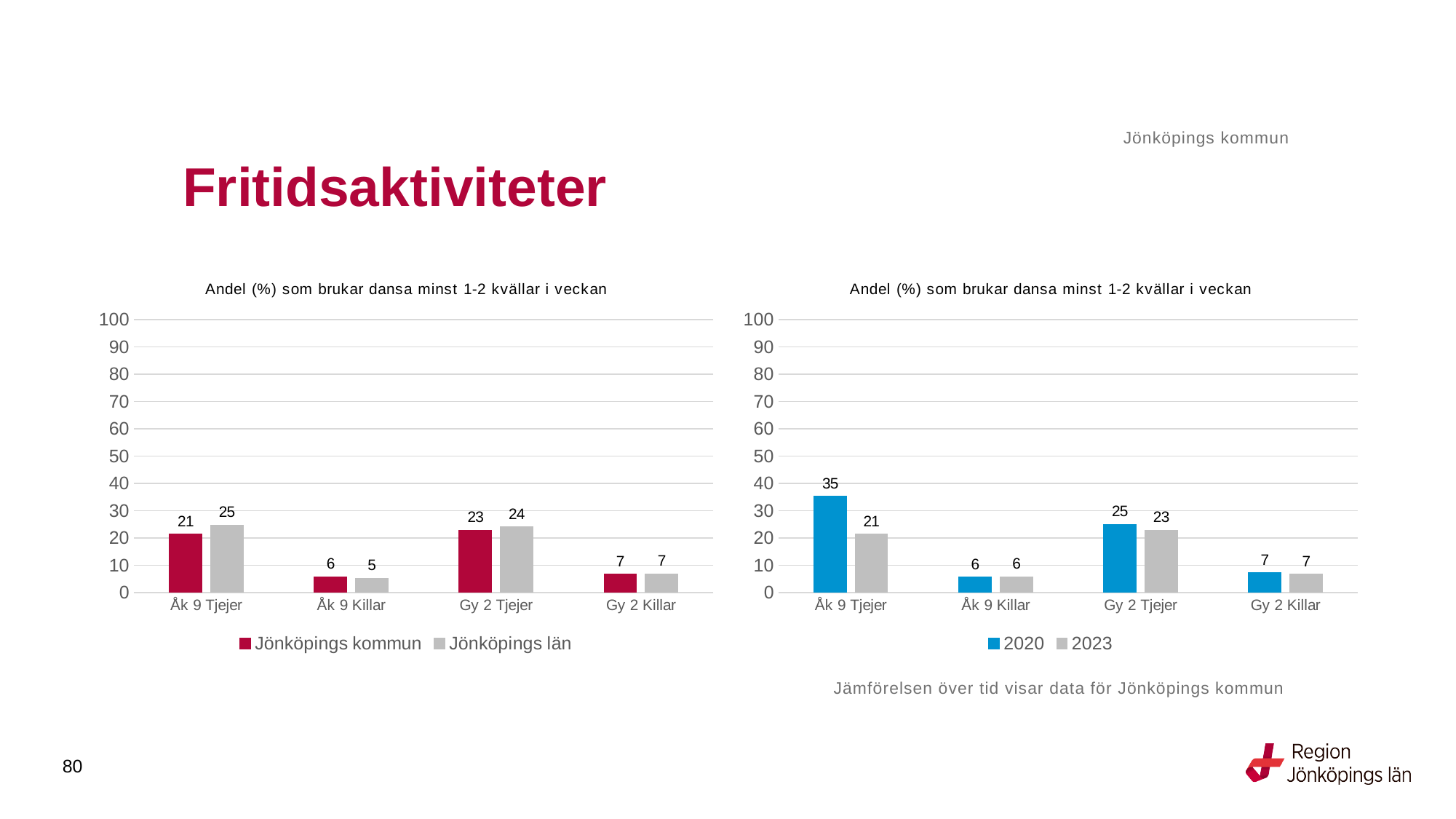
In the right chart, what is the value for 2020 for Åk 9 Tjejer? 35 In the left chart, what is the value for Jönköpings kommun for Åk 9 Tjejer? 21 In the left chart, what is the value for Jönköpings län for Gy 2 Tjejer? 24 In the right chart, which category has the highest value for 2020? Åk 9 Tjejer In the left chart, what is the difference between Jönköpings län and Jönköpings kommun for Åk 9 Tjejer? 4 How many categories are shown on the x axis of the right chart? 4 In the left chart, which category has the lowest value for Jönköpings län? Åk 9 Killar In the left chart, which is larger for Gy 2 Tjejer: Jönköpings kommun or Jönköpings län? Jönköpings län What type of chart is the right chart? Bar chart How many series does the legend of the left chart list? 2 In the right chart, what is the value for 2023 for Gy 2 Tjejer? 23 In the right chart, what is the difference between the 2020 and 2023 values for Åk 9 Tjejer? 14